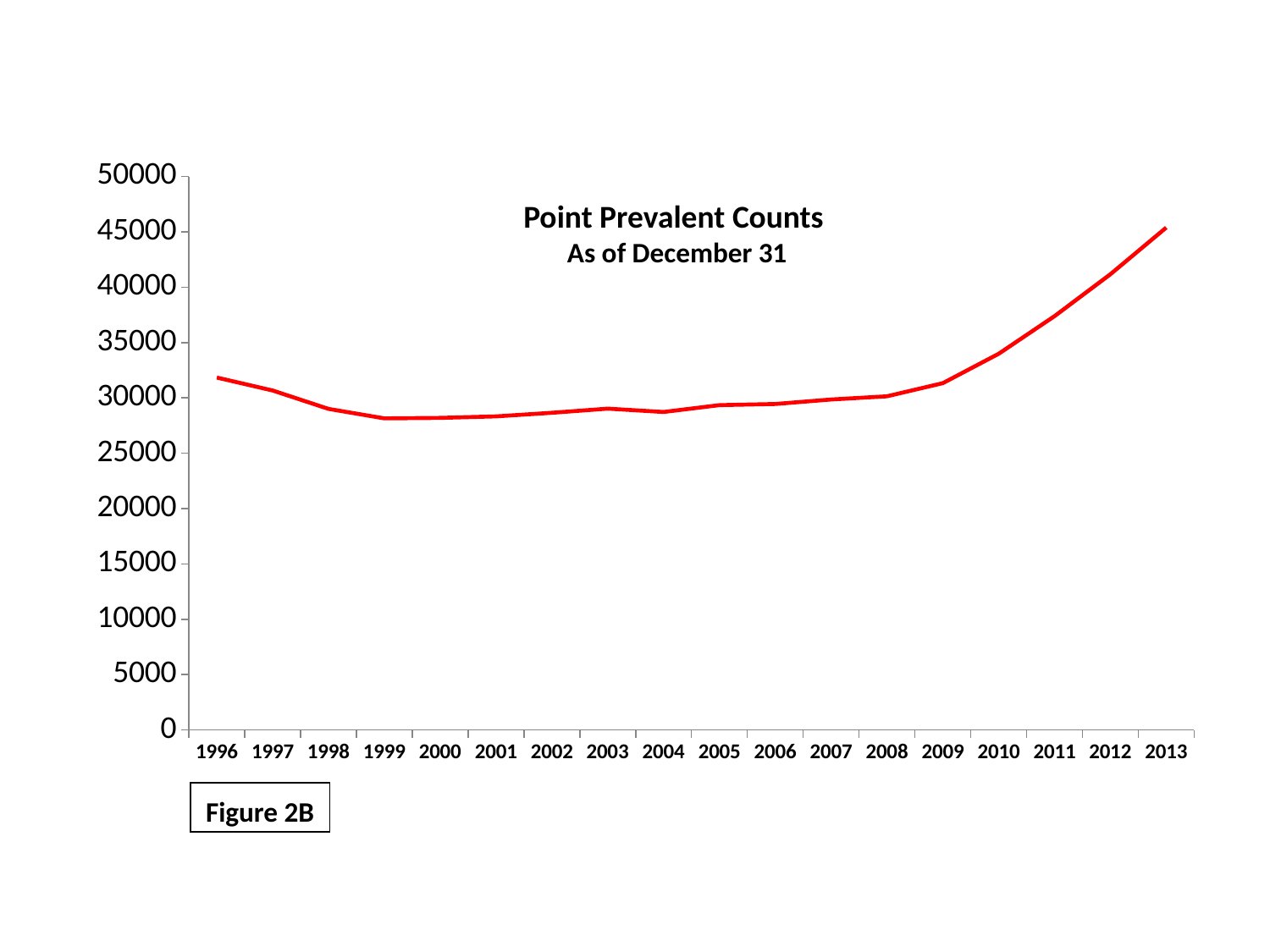
Is the value for 1996 greater or less than 30000? greater Do the values rise or fall from 1996 to 1999? fall Which year has the highest point prevalent count? 2013 Is the value for 2011 greater or less than 35000? greater Is the value for 1999 greater or less than 30000? less What kind of chart is shown on the slide? line chart Do the values rise or fall from 2009 to 2013? rise Which is larger, the value for 1996 or the value for 2004? 1996 What is the title of the chart? Point Prevalent Counts How many years are shown on the x axis? 18 What figure label appears below the chart? Figure 2B